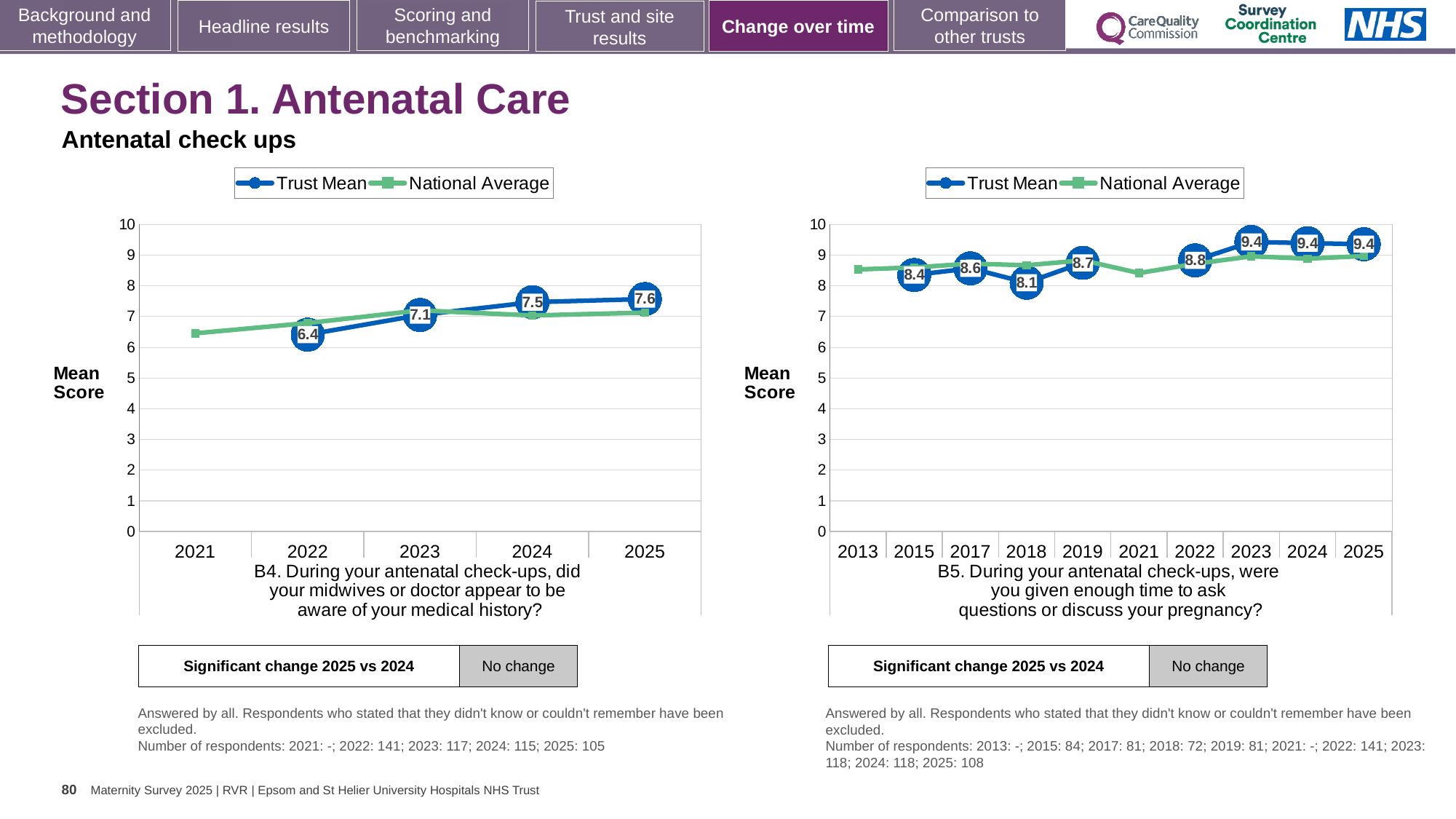
How many series does the legend of the left chart (B4) list? 2 In the right chart (B5), is the Trust Mean higher in 2019 or in 2018? 2019 What kind of chart is the left chart (B4)? Line chart In the left chart (B4), what is the Trust Mean for 2025? 7.6 In the left chart (B4), is the National Average value for 2021 greater or less than 6? greater In the left chart (B4), which year has the highest labelled Trust Mean? 2025 In the right chart (B5), what is the Trust Mean for 2018? 8.1 How many years are shown on the x axis of the right chart (B5)? 10 In the right chart (B5), which year has the lowest Trust Mean? 2018 In the left chart (B4), what is the difference between the Trust Mean in 2025 and in 2022? 1.2 In the right chart (B5), what is the difference between the Trust Mean in 2023 and in 2018? 1.3 In the left chart (B4), what is the Trust Mean for 2022? 6.4